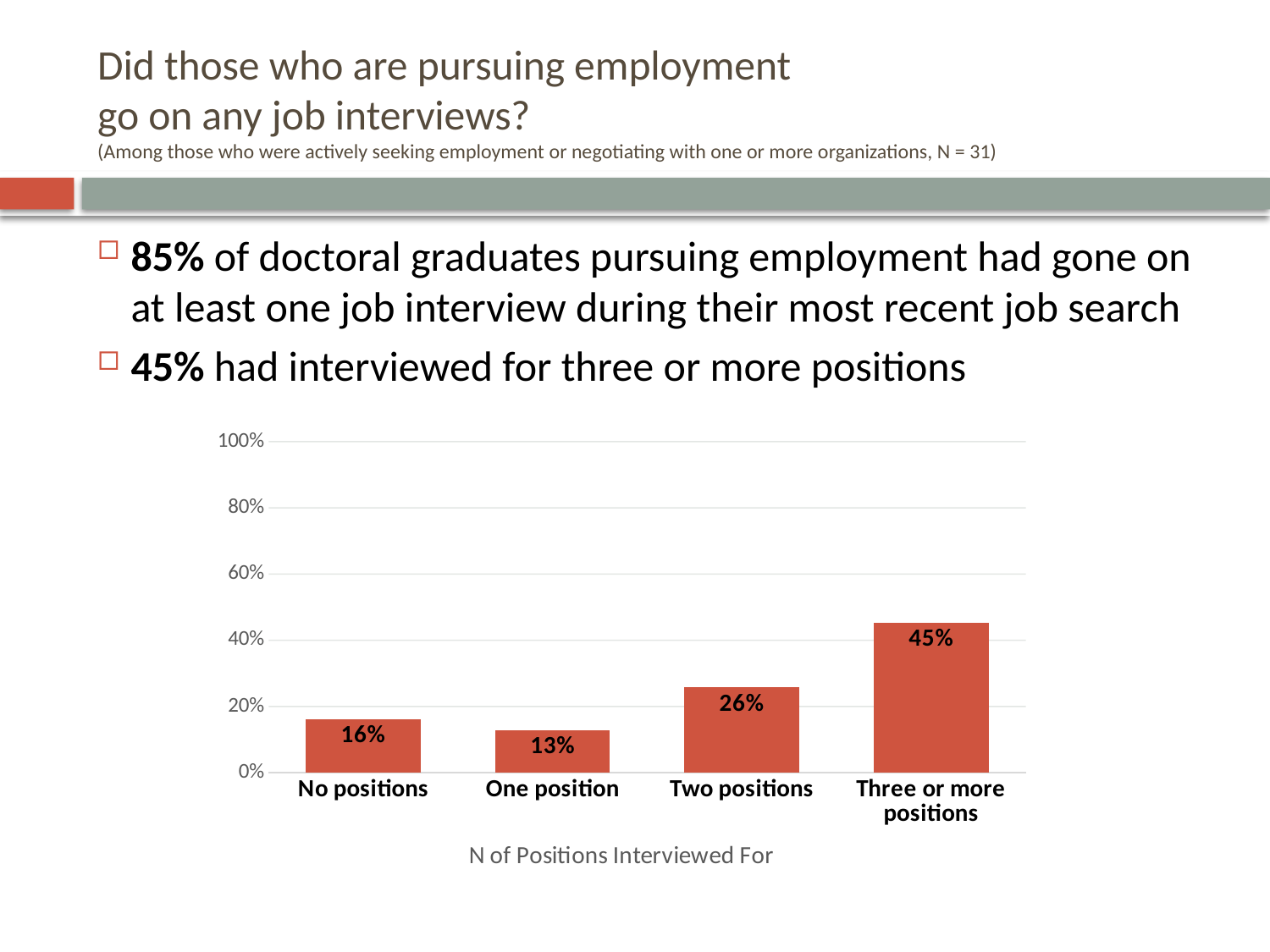
Which category has the highest value? Three or more positions What is the difference between the values for 'Three or more positions' and 'Two positions'? 19% What is the x-axis title of the chart? N of Positions Interviewed For What percentage of respondents interviewed for two positions? 26% What is the value shown for 'Three or more positions'? 45% What is the value shown for 'One position'? 13% How many categories are shown on the x axis? 4 What percentage of respondents interviewed for no positions? 16% Which is larger, the value for 'No positions' or the value for 'Two positions'? Two positions Is the value for 'Three or more positions' greater or less than 40%? greater What kind of chart is shown on the slide? Bar chart Which category has the lowest value? One position